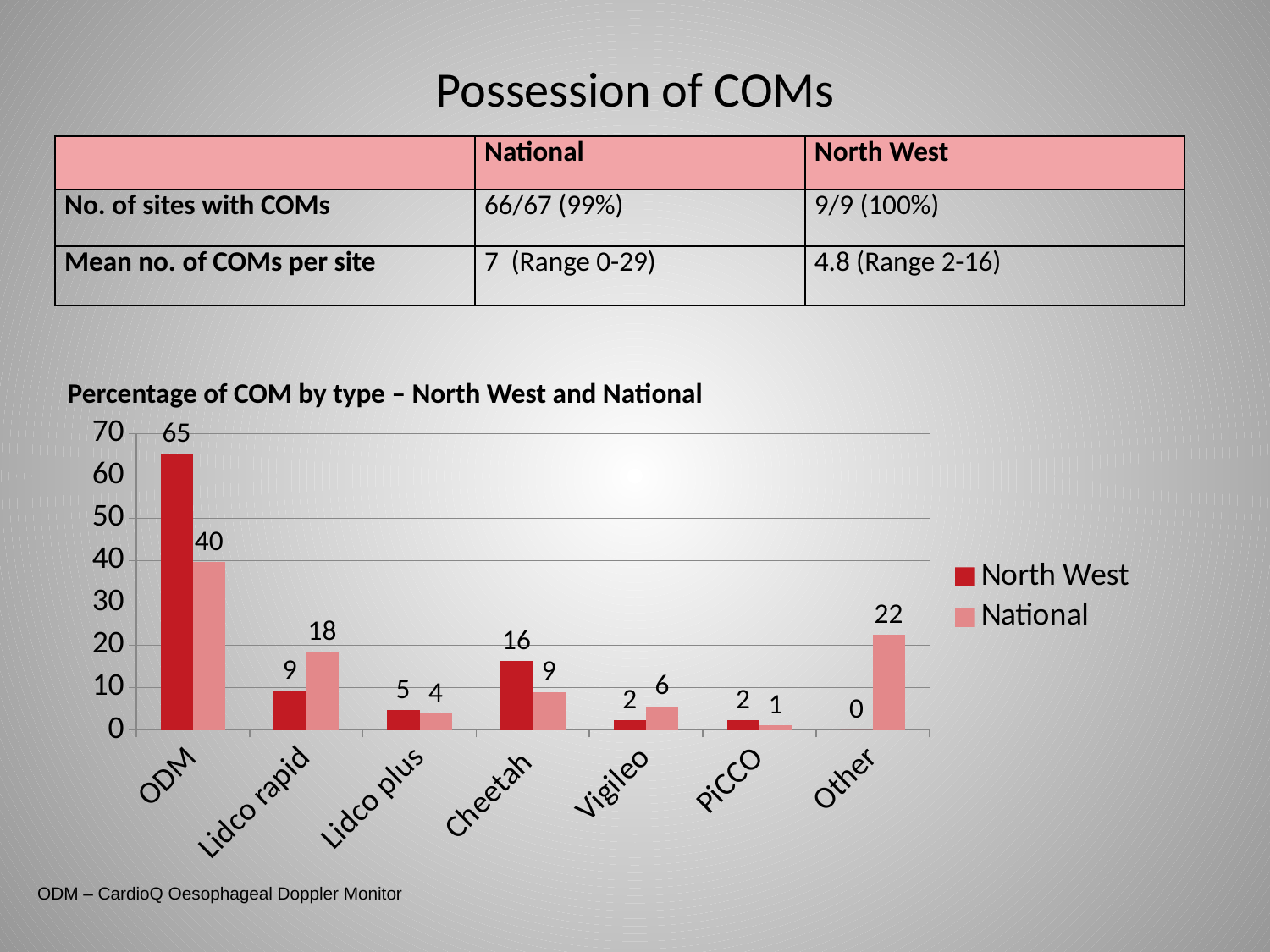
What kind of chart is shown on the slide? Bar chart Which category has the lowest North West value? Other What is the National value for Other? 22 How many categories are shown on the x axis? 7 What is the North West value for ODM? 65 Which category has the highest North West value? ODM What is the difference between the North West and National values for ODM? 25 Which is larger for Lidco rapid, the North West value or the National value? National What is the North West value for Cheetah? 16 How many series does the legend list? 2 What is the National value for Lidco rapid? 18 What is the title of the chart? Percentage of COM by type – North West and National